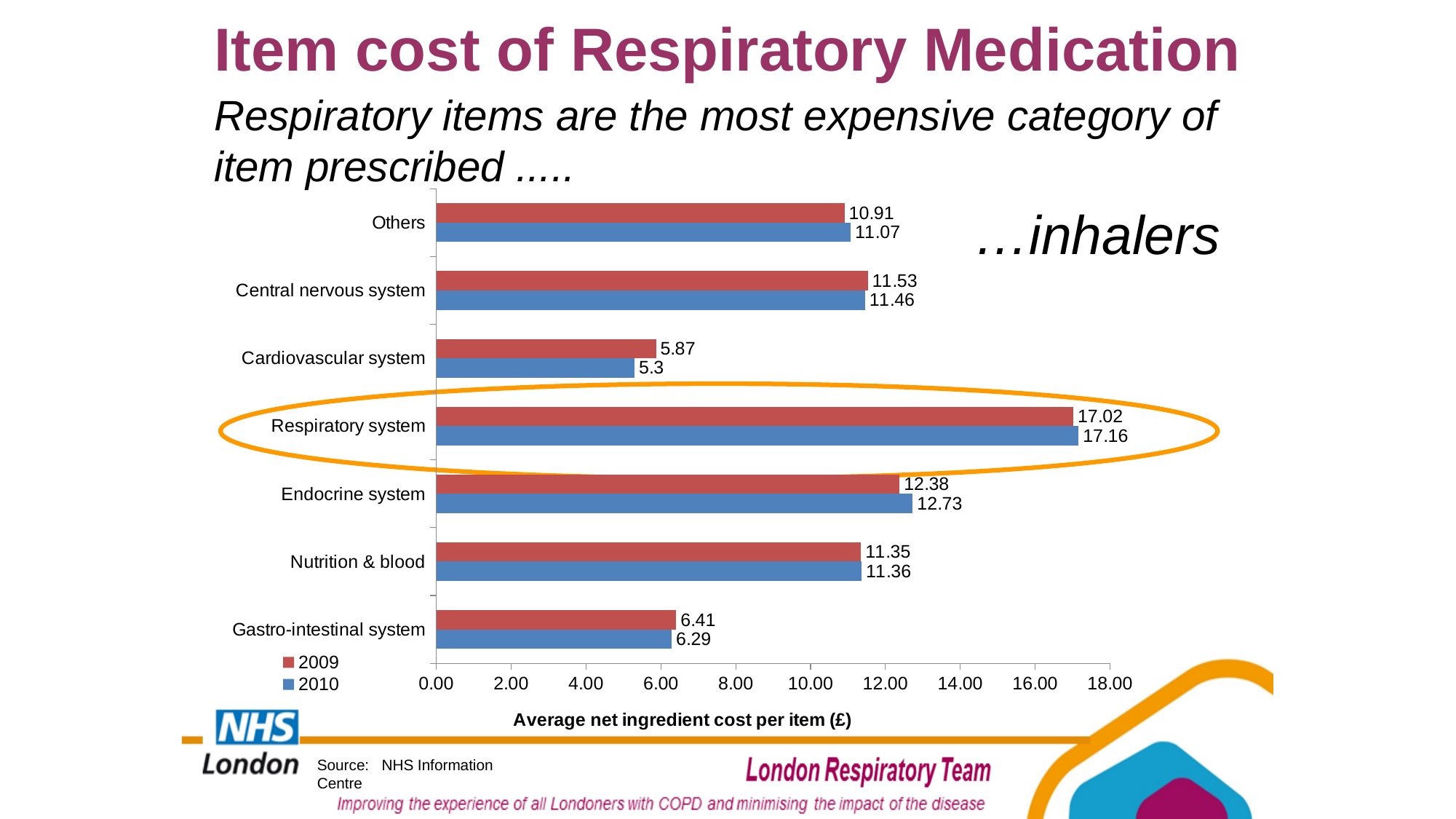
Which is larger for the Gastro-intestinal system, the 2009 value or the 2010 value? 2009 Is the 2009 value for the Respiratory system greater or less than 16.00? greater Which category has the highest 2009 average net ingredient cost per item? Respiratory system What is the difference between the 2010 and 2009 values for the Endocrine system? 0.35 How many series does the legend list? 2 What is the 2009 average net ingredient cost per item for the Cardiovascular system? 5.87 What is the 2010 average net ingredient cost per item for the Respiratory system? 17.16 What is the label of the horizontal axis? Average net ingredient cost per item (£) How many categories are shown on the chart? 7 What kind of chart is shown on the slide? Bar chart What is the 2010 value for the Endocrine system? 12.73 Which category has the lowest 2010 average net ingredient cost per item? Cardiovascular system